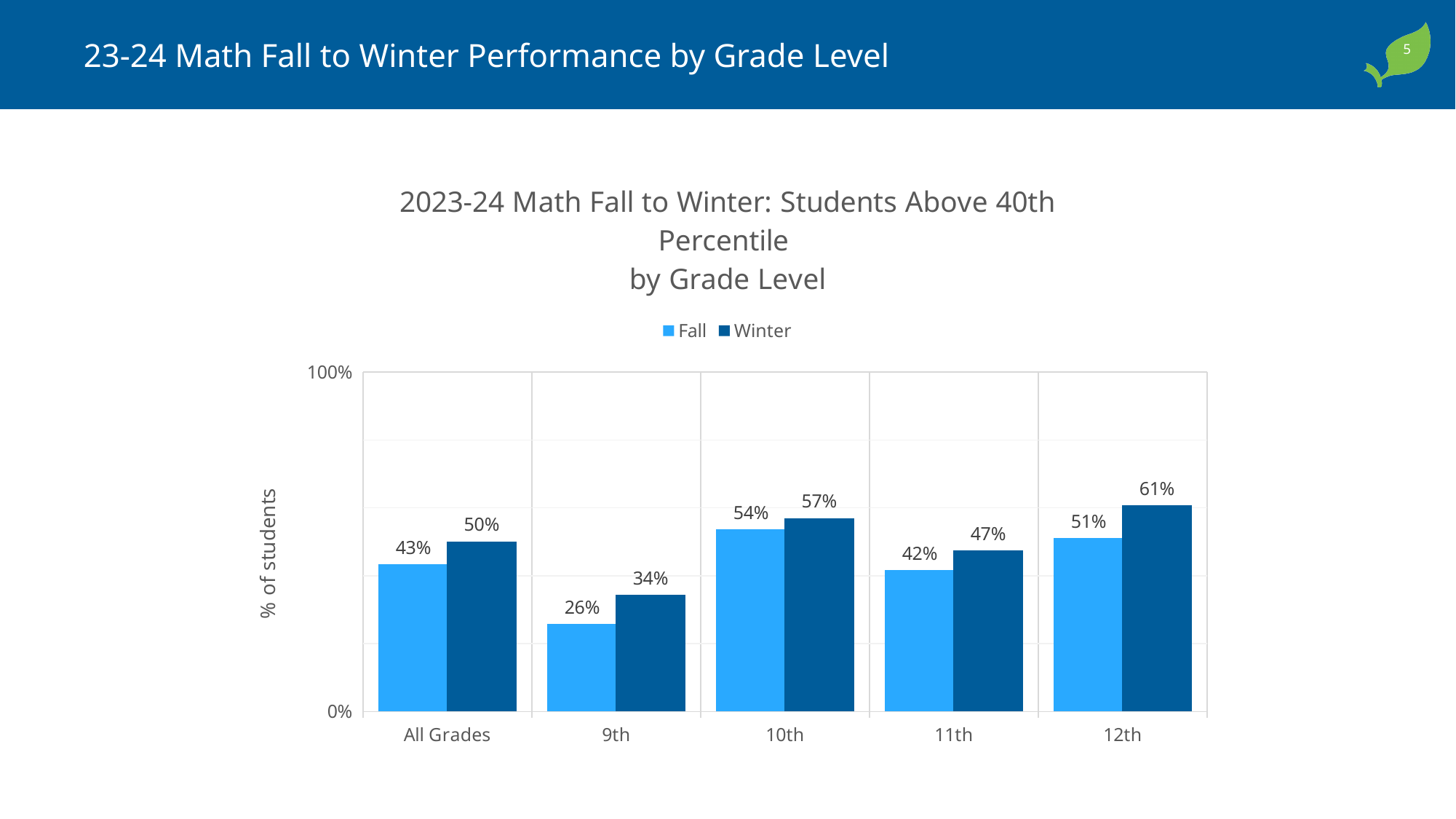
What is the Fall value for 9th grade? 26% How many grade-level categories are shown on the x axis? 5 What is the difference between the Winter values for 12th grade and 11th grade? 14% What kind of chart is shown on the slide? Bar chart How many series does the legend list? 2 Which is larger, the Fall value for 10th grade or the Fall value for 12th grade? 10th grade What is the label on the vertical axis of the chart? % of students Which grade level has the lowest Fall value? 9th What is the Winter value for 12th grade? 61% Which grade level has the highest Winter value? 12th What is the Winter value for All Grades? 50% What is the difference between the Winter and Fall values for 9th grade? 8%